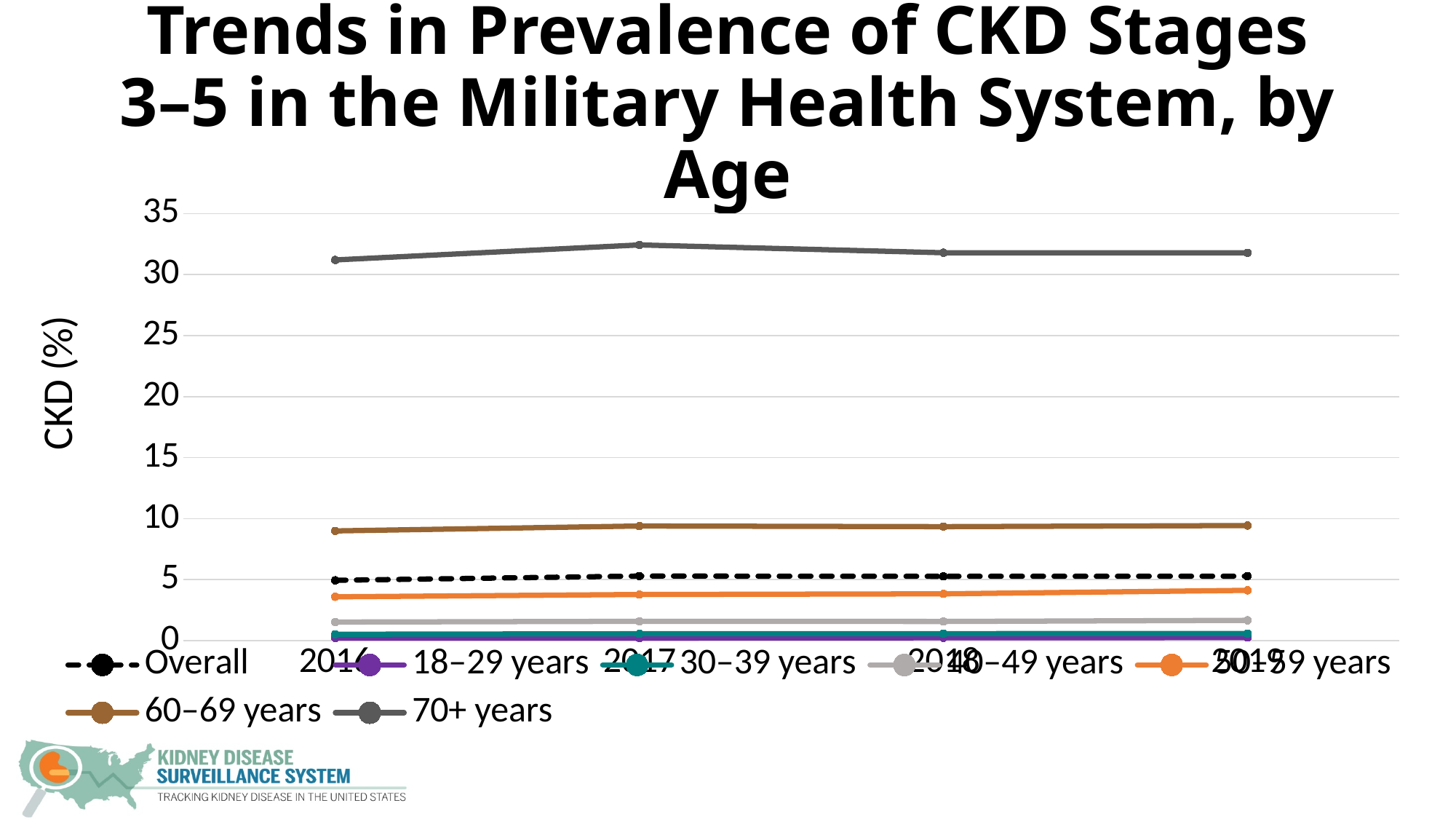
What kind of chart is shown on the slide? line chart Is the value for 70+ years in 2017 greater or less than 30? greater Does the value for 70+ years rise or fall from 2016 to 2017? rise Which is larger in 2018, the value for 60–69 years or the value for 50–59 years? 60–69 years Is the value for 60–69 years in 2019 greater or less than 10? less Is the value for 50–59 years in 2016 greater or less than 5? less How many data points are plotted for each series? 4 What is the label on the y axis? CKD (%) Which age group has the highest CKD prevalence across all years? 70+ years How many series does the legend list? 7 Which is larger in 2019, the value for Overall or the value for 40–49 years? Overall